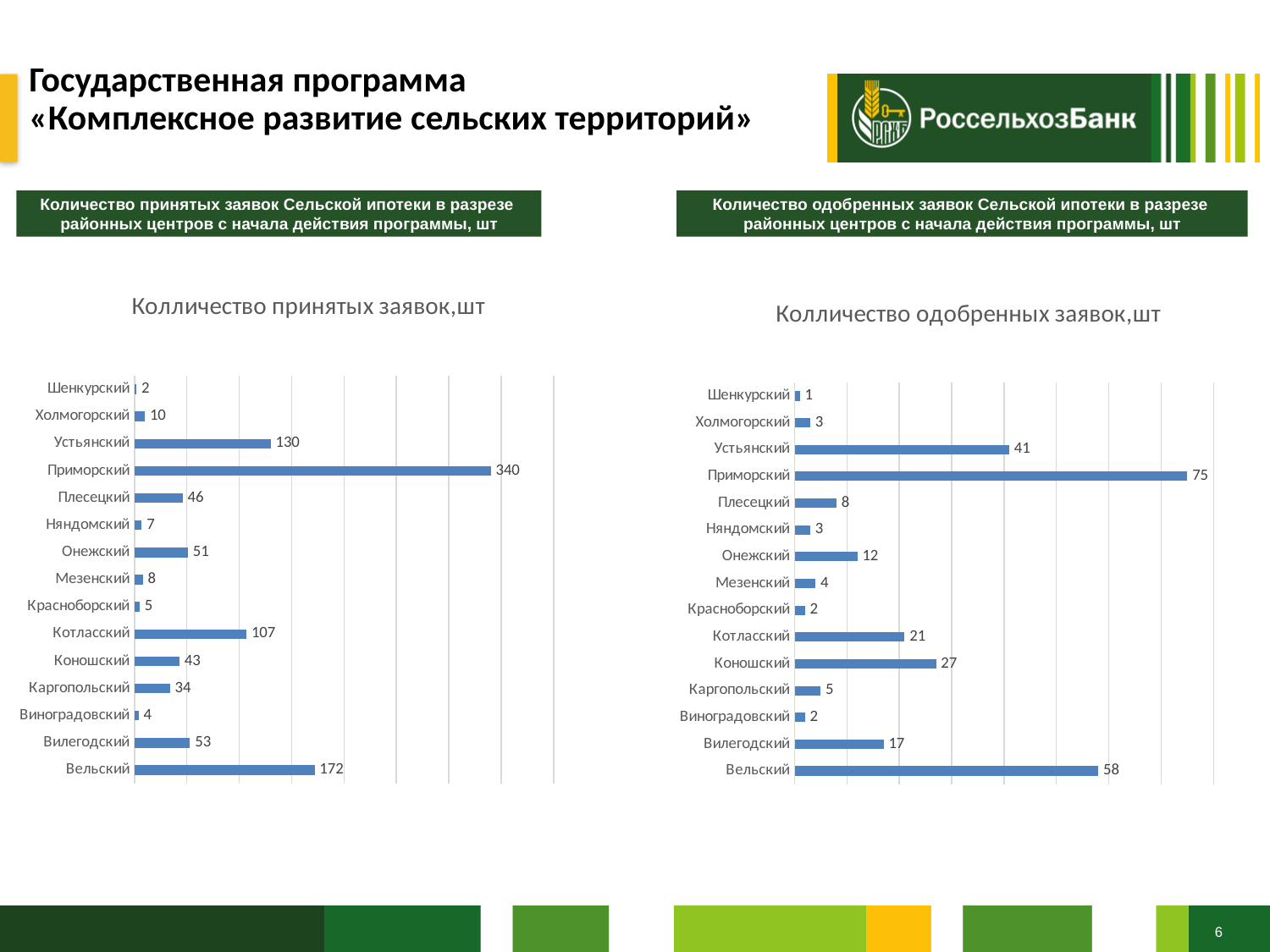
What kind of chart is the right chart (Колличество одобренных заявок,шт)? Bar chart In the left chart (Колличество принятых заявок,шт), what is the value for Каргопольский? 34 How many categories are shown in the left chart (Колличество принятых заявок,шт)? 15 In the right chart (Колличество одобренных заявок,шт), which category has the lowest value? Шенкурский In the left chart (Колличество принятых заявок,шт), which is larger: the value for Котласский or the value for Онежский? Котласский In the left chart (Колличество принятых заявок,шт), which category has the highest value? Приморский In the right chart (Колличество одобренных заявок,шт), which is larger: the value for Коношский or the value for Котласский? Коношский In the left chart (Колличество принятых заявок,шт), what is the value for Приморский? 340 In the right chart (Колличество одобренных заявок,шт), what is the difference between the values for Приморский and Вельский? 17 In the right chart (Колличество одобренных заявок,шт), what is the value for Вельский? 58 In the left chart (Колличество принятых заявок,шт), what is the difference between the values for Вельский and Устьянский? 42 What is the title of the right chart? Колличество одобренных заявок,шт